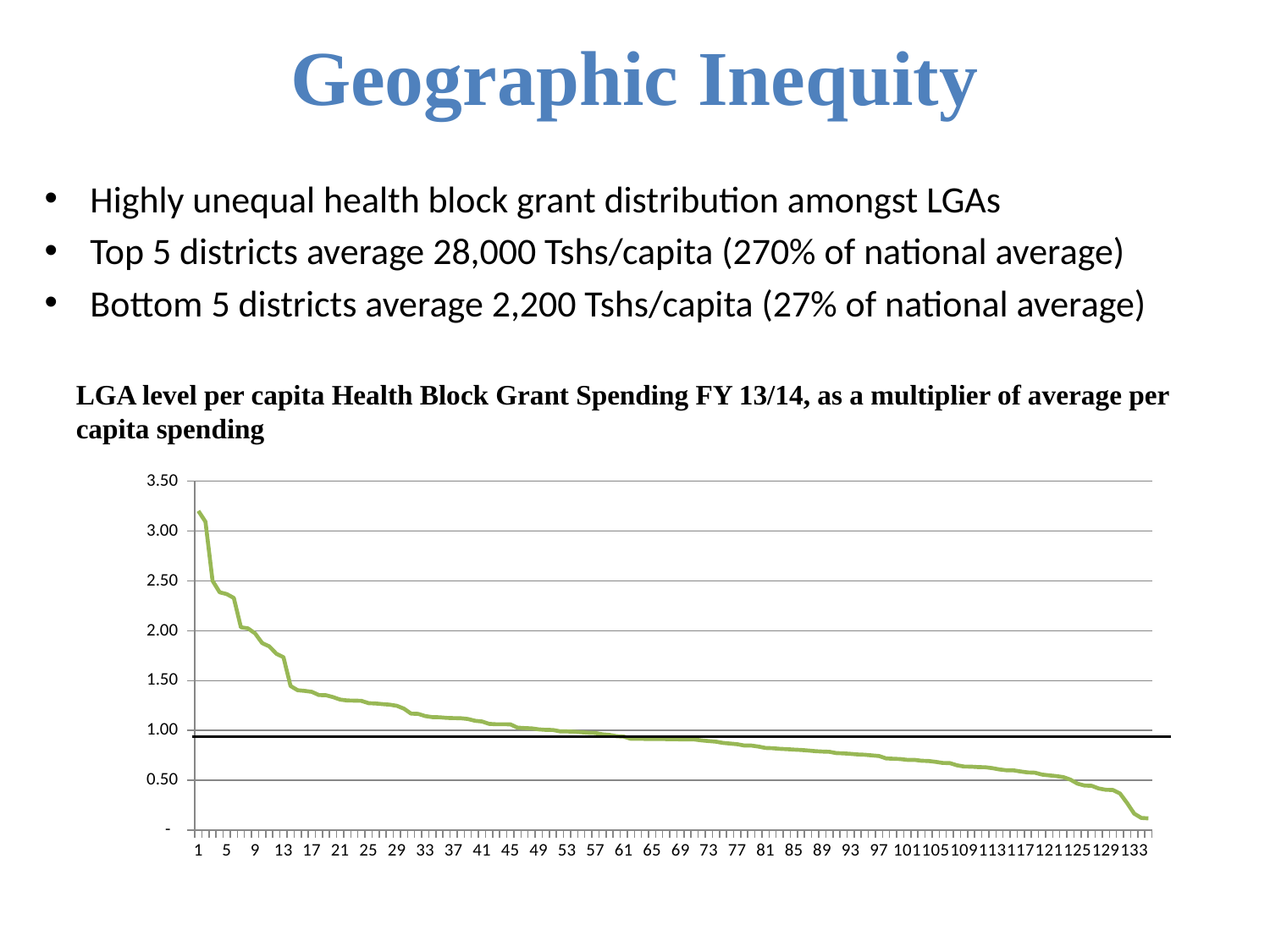
Which x-axis position has the highest value? 1 What kind of chart is shown on the slide? line chart Is the value at x-axis position 133 greater or less than 0.50? less What is the title of the chart? LGA level per capita Health Block Grant Spending FY 13/14, as a multiplier of average per capita spending Do the values rise or fall as you move from left to right along the x axis? fall Is the value at x-axis position 1 greater or less than 3.00? greater Is the value at x-axis position 101 greater or less than 1.00? less What is the highest tick value shown on the y axis? 3.50 Is the value at x-axis position 1 larger or smaller than the value at x-axis position 133? larger